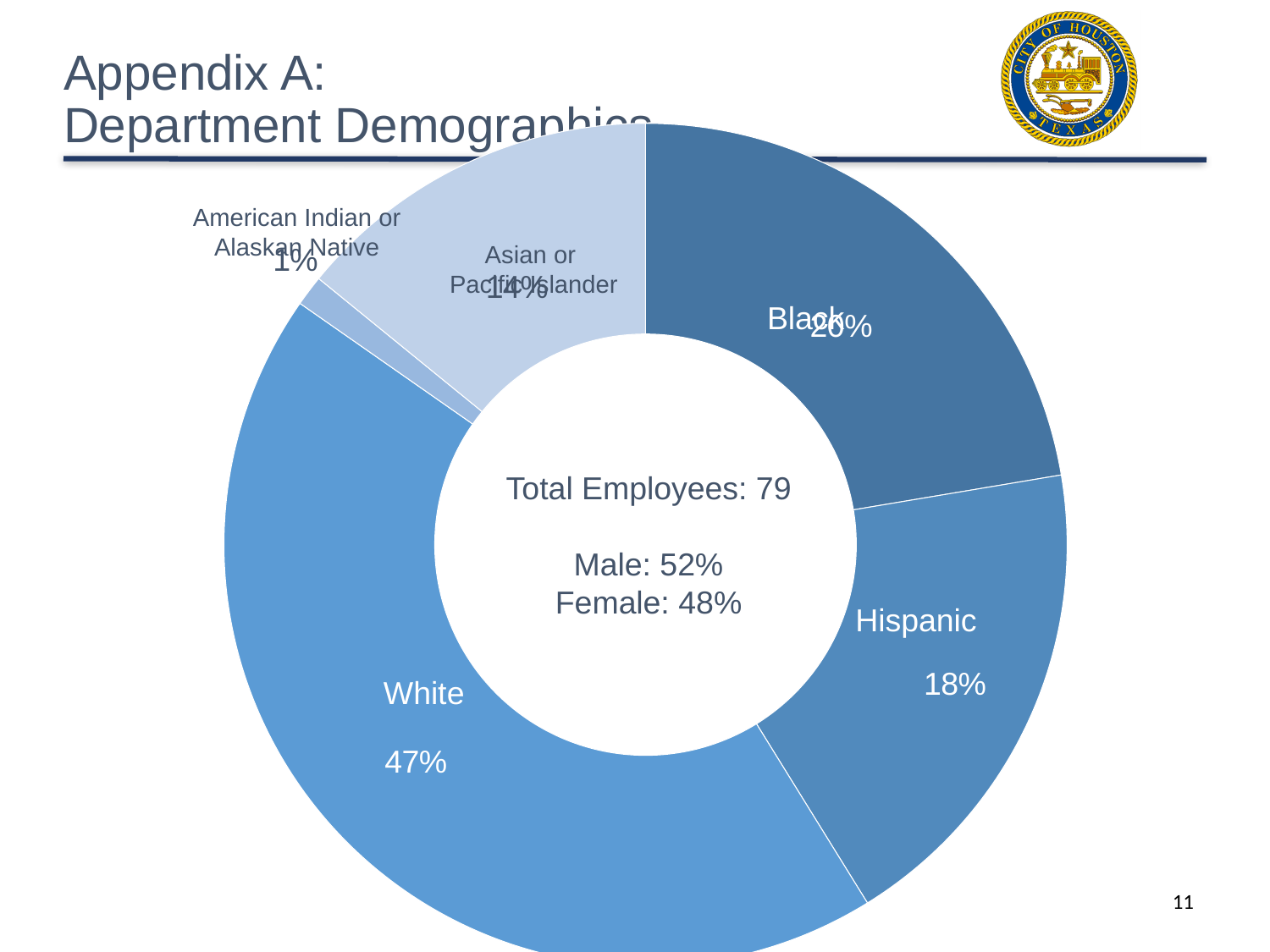
What is the difference in percentage points between the White and Hispanic shares? 29 Which demographic group has the smallest share of the department? American Indian or Alaskan Native What percentage of the department is American Indian or Alaskan Native? 1% Which demographic group has the largest share of the department? White What percentage of the department is White? 47% What is the total number of employees shown in the center of the chart? 79 Which group has a larger share, Black or Hispanic? Black What kind of chart is shown on the slide? Doughnut chart What percentage of the department is Black? 20% What percentage of the department is Asian or Pacific Islander? 14% What percentage of the department is Hispanic? 18% How many demographic categories are shown in the chart? 5